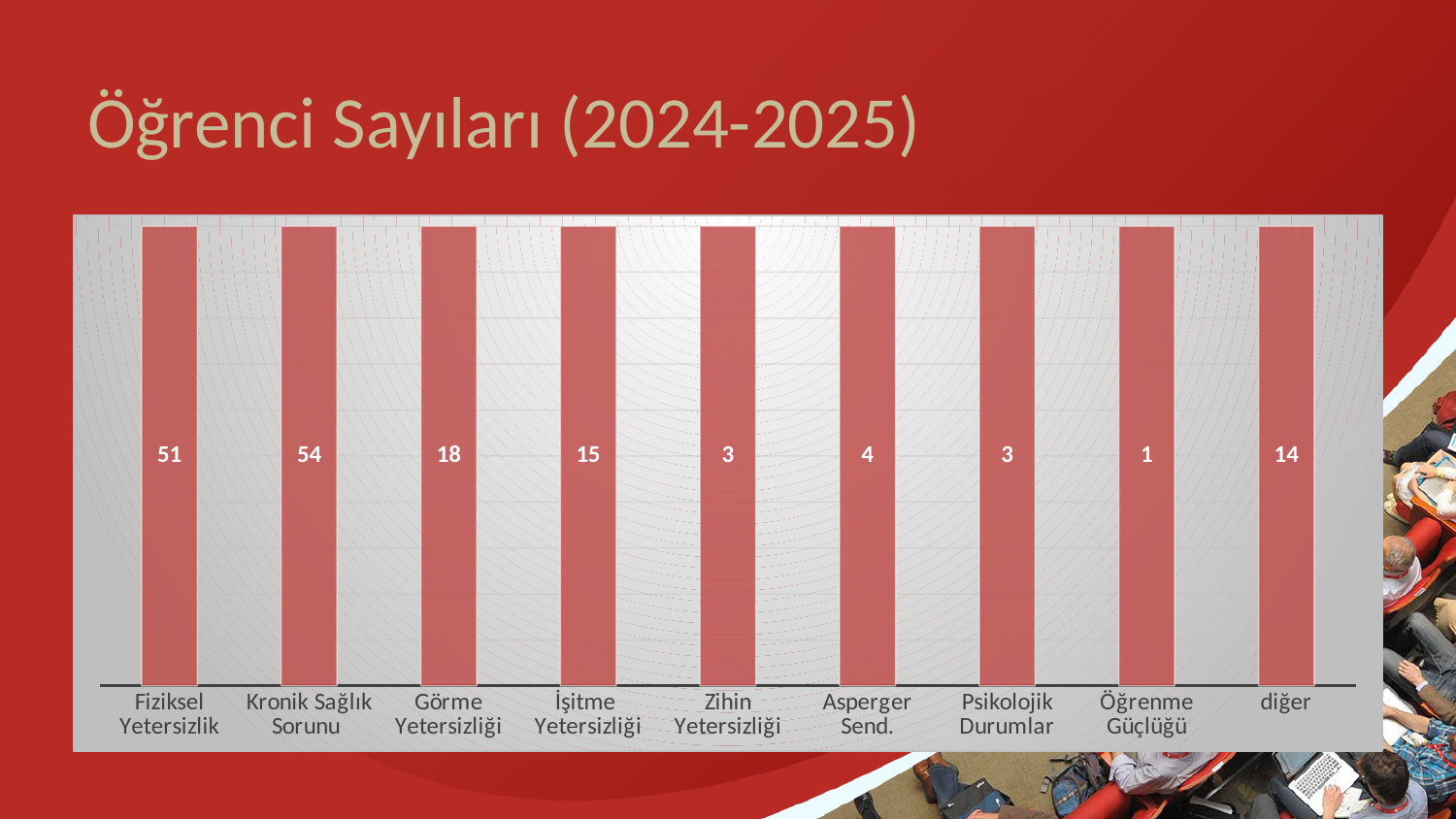
What is the value for diğer? 14 What is the title of the slide containing the chart? Öğrenci Sayıları (2024-2025) What is the difference between the values for Görme Yetersizliği and İşitme Yetersizliği? 3 What is the difference between the values for Kronik Sağlık Sorunu and Fiziksel Yetersizlik? 3 What is the value for Kronik Sağlık Sorunu? 54 What is the value for Fiziksel Yetersizlik? 51 How many categories are shown on the x axis? 9 What kind of chart is shown on the slide? Bar chart Which category has the highest value? Kronik Sağlık Sorunu What is the value for Görme Yetersizliği? 18 Which category has the lowest value? Öğrenme Güçlüğü Which is larger, the value for Asperger Send. or the value for Öğrenme Güçlüğü? Asperger Send.